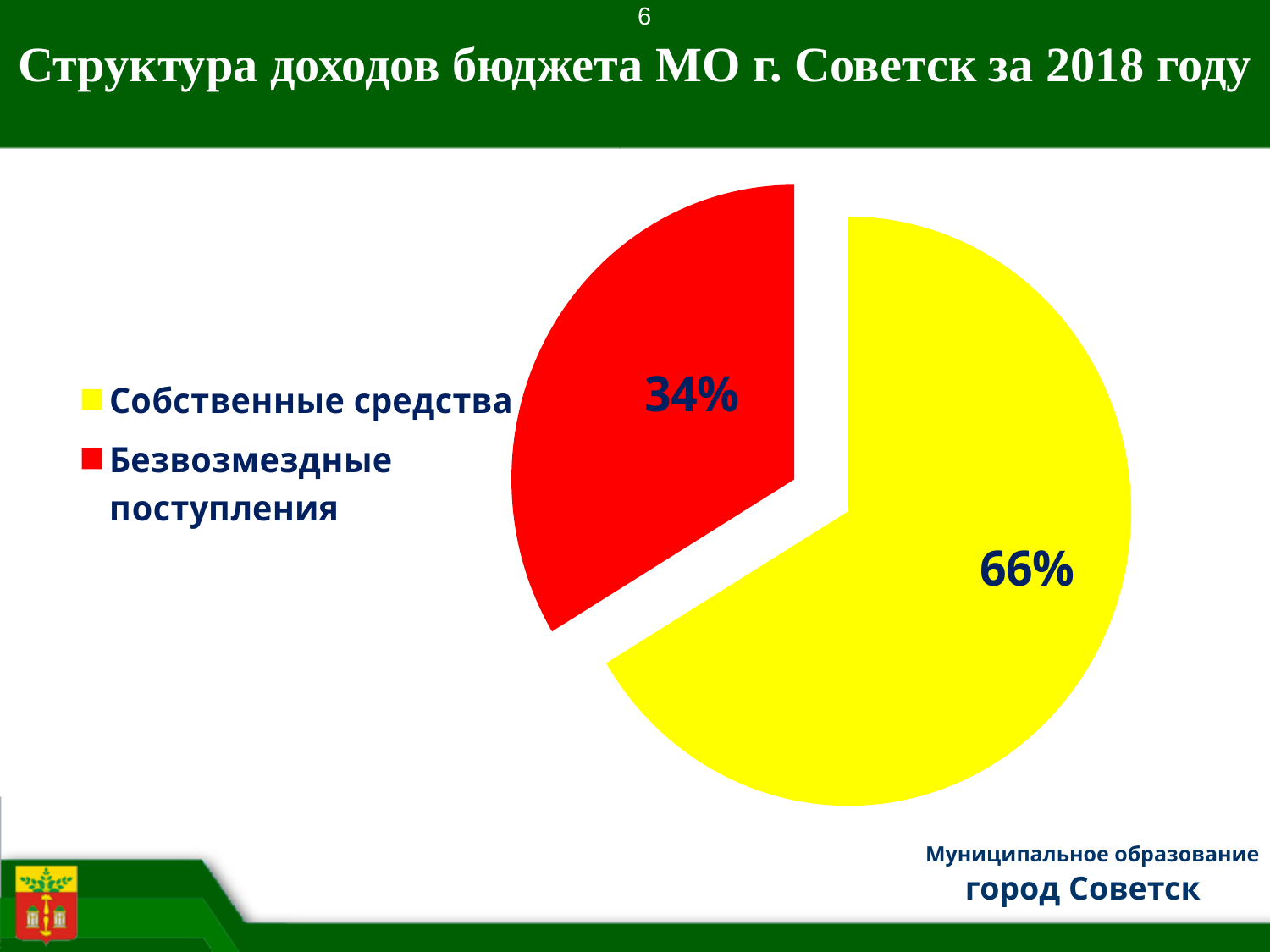
What is the difference in percentage points between Собственные средства and Безвозмездные поступления? 32 What is the title of the slide? Структура доходов бюджета МО г. Советск за 2018 году Which category has the largest slice of the pie? Собственные средства How many slices does the pie chart have? 2 How many entries does the legend list? 2 What share of the pie does Безвозмездные поступления have? 34% Which is larger: Собственные средства or Безвозмездные поступления? Собственные средства What kind of chart is shown on the slide? pie chart What colour is the slice for Безвозмездные поступления? red What share of the pie does Собственные средства have? 66% Which category has the smallest slice of the pie? Безвозмездные поступления